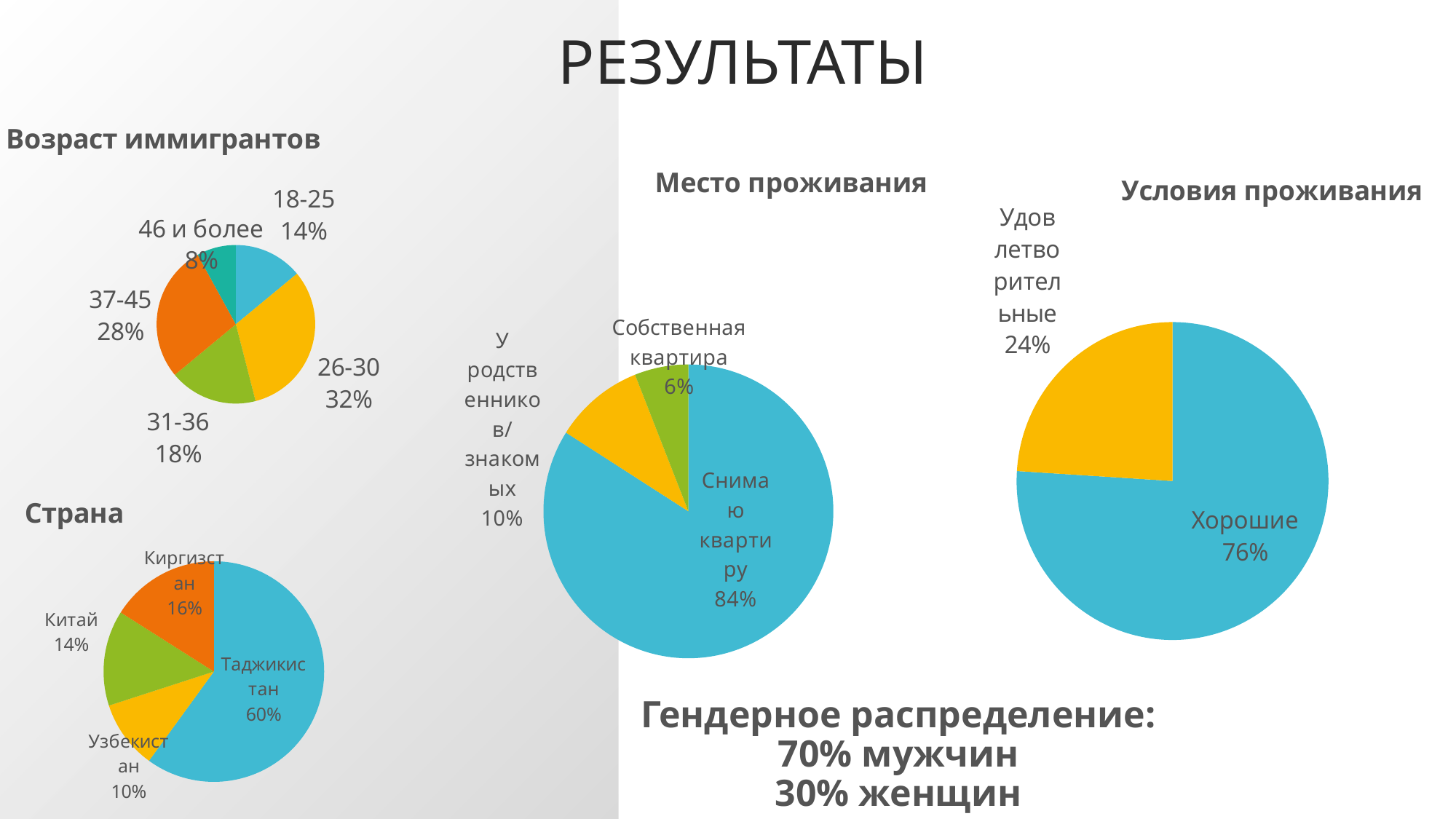
In the 'Страна' chart, how many countries are shown? 4 In the 'Страна' chart, what share is Таджикистан? 60% In the 'Страна' chart, which is larger: Киргизстан or Китай? Киргизстан In the 'Возраст иммигрантов' chart, how many age groups are shown? 5 In the 'Место проживания' chart, what share is 'Собственная квартира'? 6% In the 'Место проживания' chart, what is the difference between 'Снимаю квартиру' and 'У родственников/знакомых'? 74% In the 'Возраст иммигрантов' chart, what share is the 26-30 age group? 32% In the 'Страна' chart, which country has the largest share? Таджикистан In the 'Возраст иммигрантов' chart, which age group has the smallest share? 46 и более What type of chart is used for 'Условия проживания'? Pie chart In the 'Условия проживания' chart, what share is 'Удовлетворительные'? 24% In the 'Возраст иммигрантов' chart, what is the difference between the shares of the 37-45 and 31-36 groups? 10%